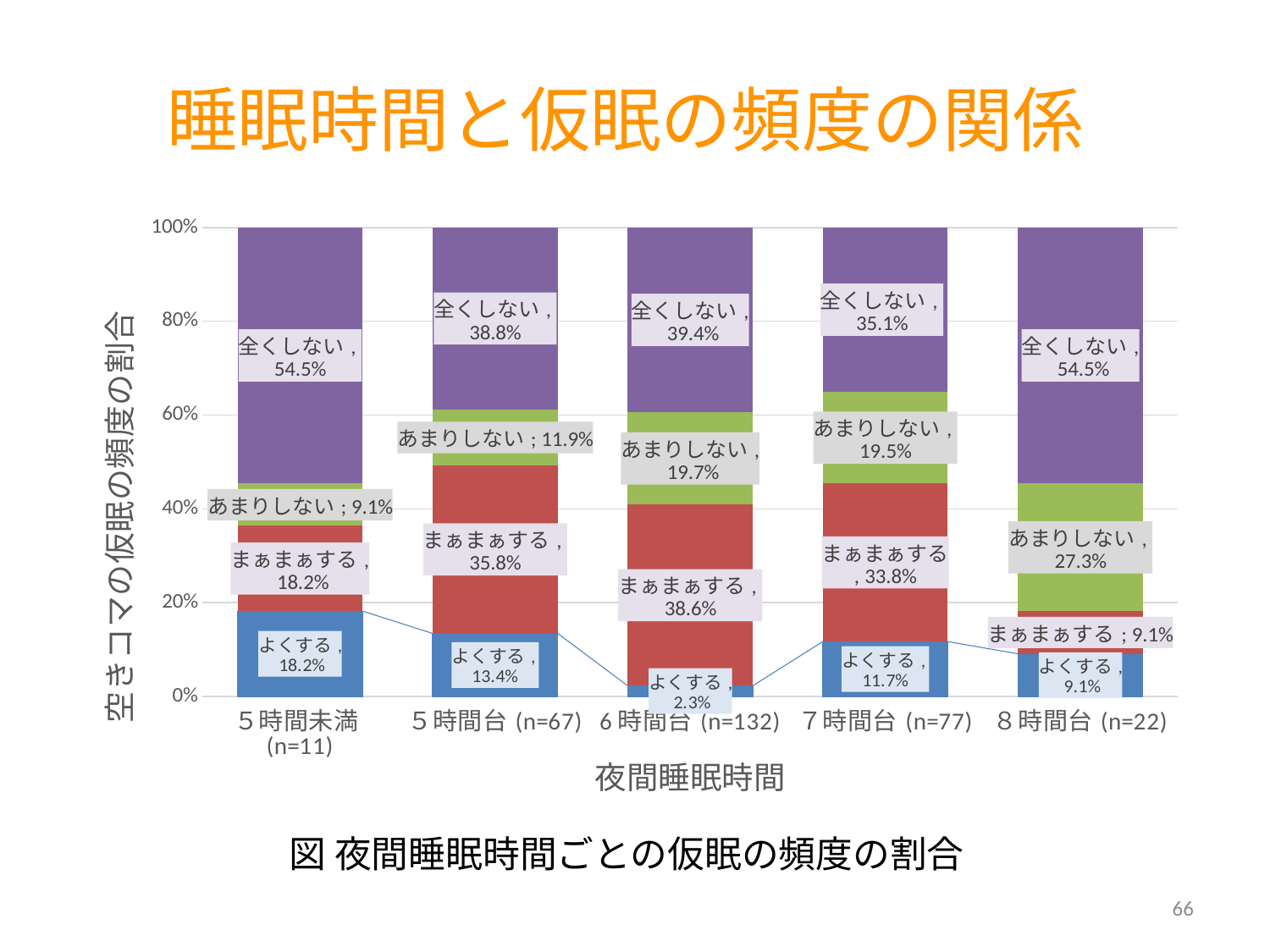
How many nap-frequency categories are stacked in each bar? 4 What is the value for よくする in the 5時間台 (n=67) bar? 13.4% What is the difference between the 全くしない values for 5時間未満 (n=11) and 7時間台 (n=77)? 19.4% Which sleep-duration group has the highest value for まぁまぁする? 6時間台 (n=132) What is the value for 全くしない in the 6時間台 (n=132) bar? 39.4% Which is larger: the あまりしない value for 5時間台 (n=67) or for 6時間台 (n=132)? 6時間台 (n=132) What is the value for あまりしない in the 8時間台 (n=22) bar? 27.3% Which sleep-duration group has the lowest value for よくする? 6時間台 (n=132) What is the label of the x axis of the chart? 夜間睡眠時間 What kind of chart is shown on the slide? Stacked bar chart How many sleep-duration groups are shown on the x axis? 5 What is the value for まぁまぁする in the 7時間台 (n=77) bar? 33.8%